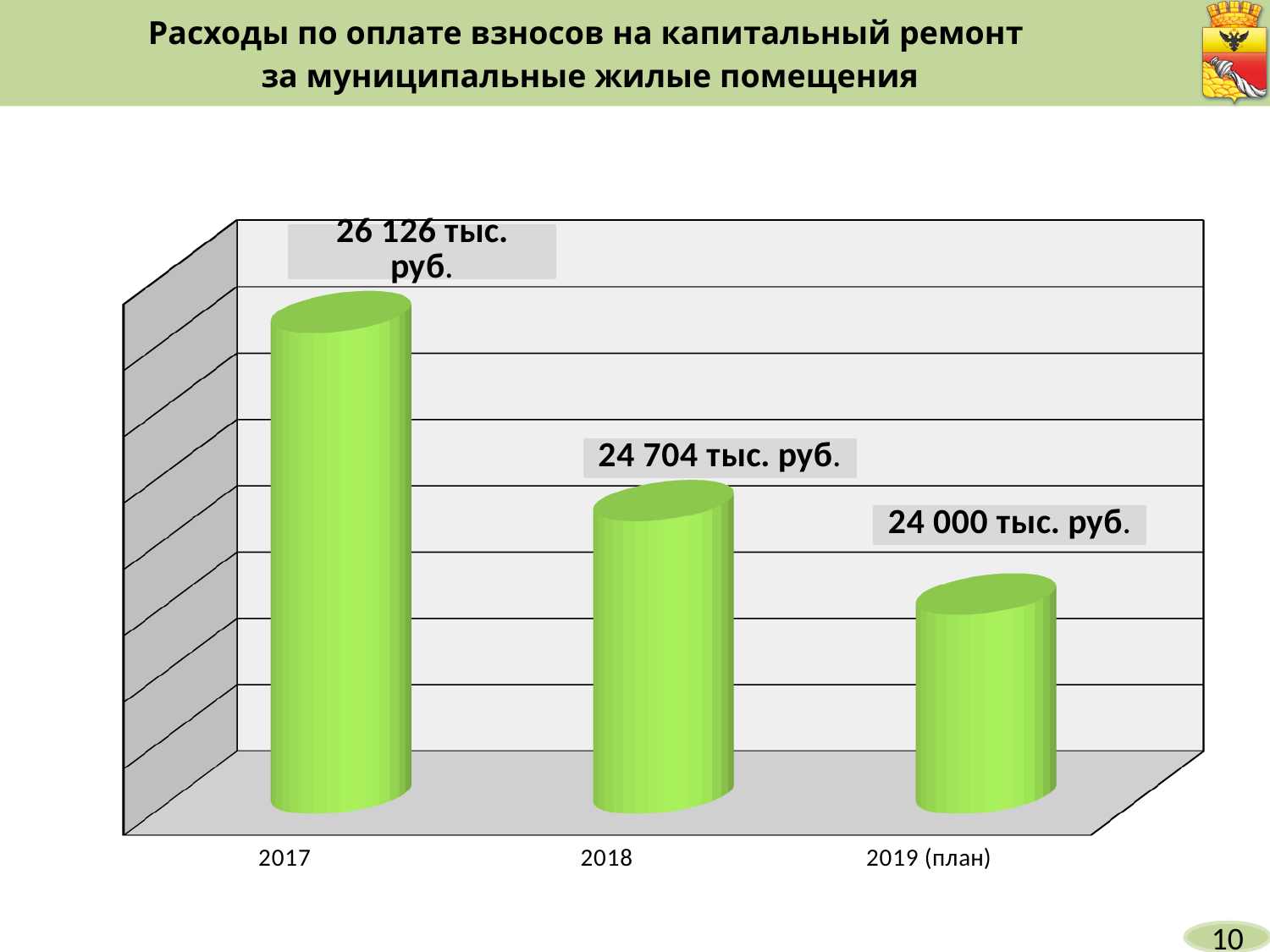
Do the values rise or fall from 2017 to 2019 (план)? Fall Which is larger, the value for 2017 or the value for 2018? 2017 What is the difference between the values for 2017 and 2018? 1 422 тыс. руб. What is the value shown for 2018? 24 704 тыс. руб. What is the value shown for 2019 (план)? 24 000 тыс. руб. Which category has the lowest value? 2019 (план) What is the difference between the values for 2017 and 2019 (план)? 2 126 тыс. руб. How many categories are shown on the chart? 3 What is the difference between the values for 2018 and 2019 (план)? 704 тыс. руб. What is the value shown for 2017? 26 126 тыс. руб. Which year has the highest value? 2017 What kind of chart is shown on the slide? Bar chart